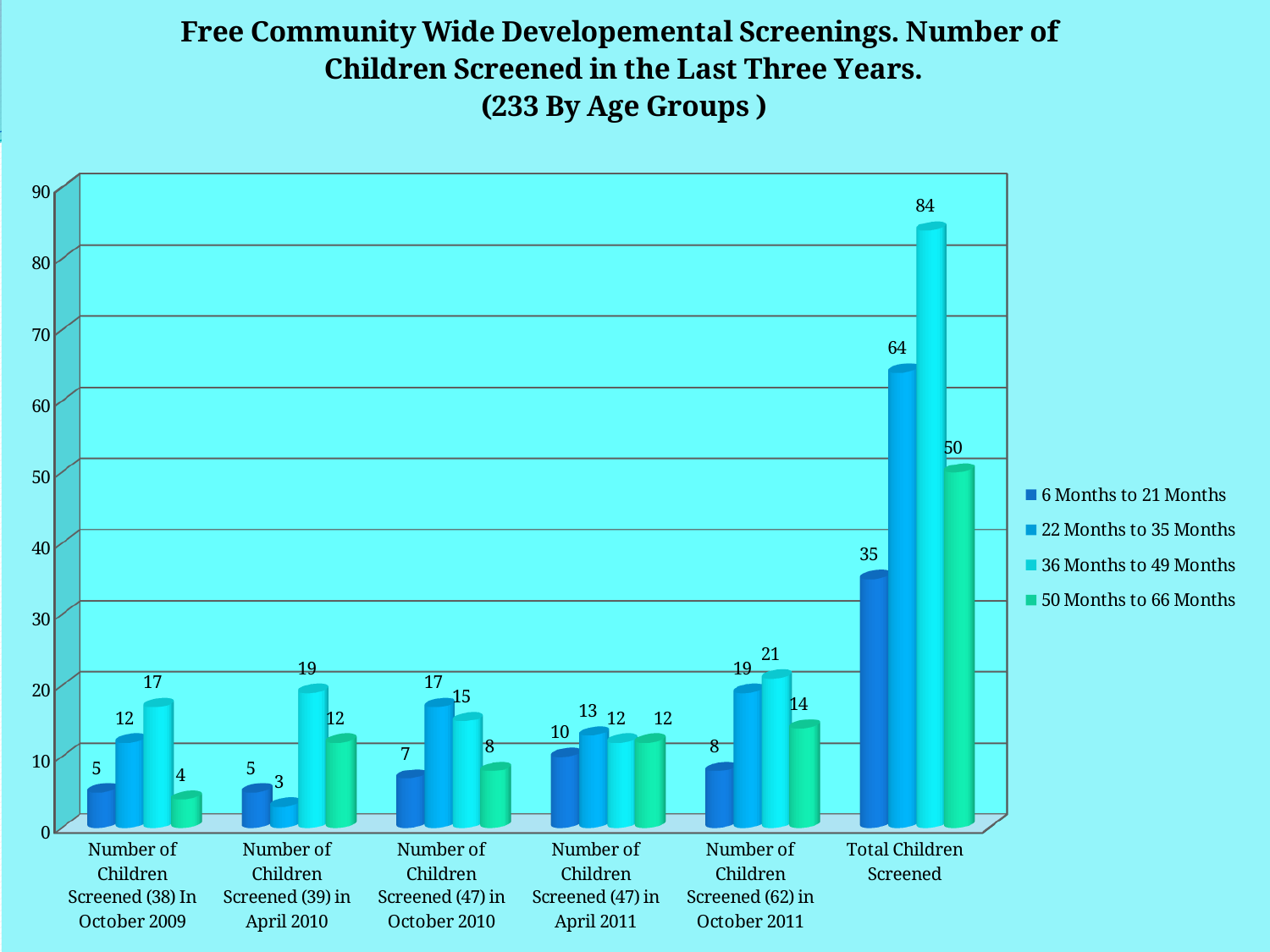
What is the value for 22 Months to 35 Months in October 2011 (Number of Children Screened (62))? 19 What is the value for 50 Months to 66 Months in April 2011 (Number of Children Screened (47))? 12 Which age group has the highest value in the Total Children Screened category? 36 Months to 49 Months Which is larger in October 2010: the value for 22 Months to 35 Months or the value for 36 Months to 49 Months? 22 Months to 35 Months How many categories are shown on the x axis? 6 How many series does the legend list? 4 What kind of chart is shown on the slide? Bar chart What is the value for 36 Months to 49 Months in the Total Children Screened category? 84 What is the value for 6 Months to 21 Months in October 2009 (Number of Children Screened (38))? 5 Which legend entry is shown in green? 50 Months to 66 Months What is the difference between the 36 Months to 49 Months and 22 Months to 35 Months values in the Total Children Screened category? 20 Which age group has the lowest value in April 2010 (Number of Children Screened (39))? 22 Months to 35 Months